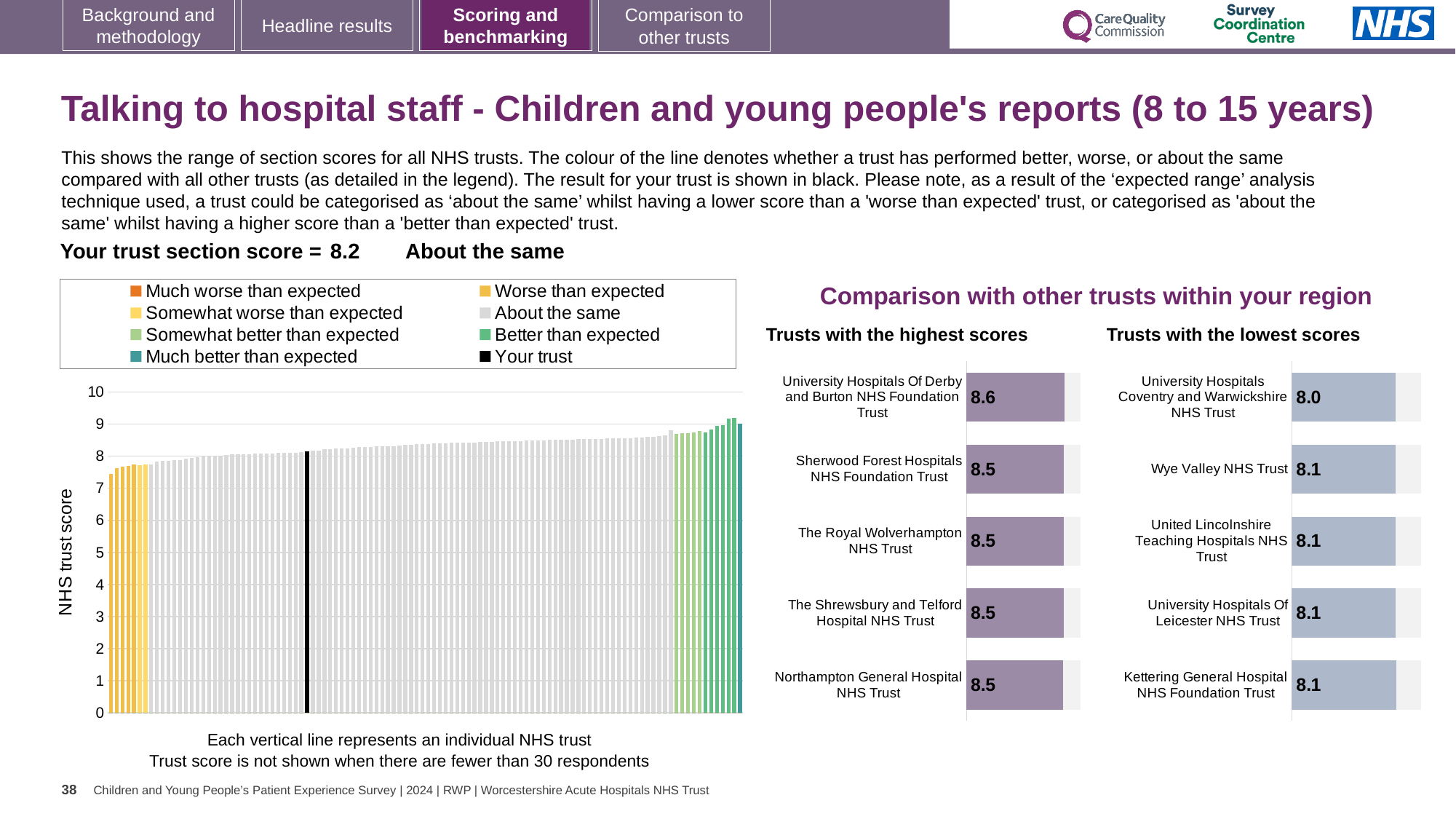
In the 'Trusts with the highest scores' chart, what is the score for University Hospitals Of Derby and Burton NHS Foundation Trust? 8.6 In the large chart on the left showing the range of section scores, do the bar values rise or fall from left to right? Rise In the large chart on the left showing the range of section scores, what kind of chart is it? Bar chart In the 'Trusts with the highest scores' chart, what is the difference between the scores of University Hospitals Of Derby and Burton NHS Foundation Trust and Sherwood Forest Hospitals NHS Foundation Trust? 0.1 In the 'Trusts with the lowest scores' chart, what is the score for University Hospitals Coventry and Warwickshire NHS Trust? 8.0 In the 'Trusts with the highest scores' chart, what is the score for Northampton General Hospital NHS Trust? 8.5 In the 'Trusts with the highest scores' chart, which trust has the highest score? University Hospitals Of Derby and Burton NHS Foundation Trust In the 'Trusts with the lowest scores' chart, which trust has the lowest score? University Hospitals Coventry and Warwickshire NHS Trust In the large chart on the left showing the range of section scores, how many entries does the legend list? 8 In the 'Trusts with the lowest scores' chart, which has the larger score: Wye Valley NHS Trust or University Hospitals Coventry and Warwickshire NHS Trust? Wye Valley NHS Trust In the 'Trusts with the lowest scores' chart, how many trusts are listed? 5 In the large chart on the left showing the range of section scores, what is the label on the vertical axis? NHS trust score